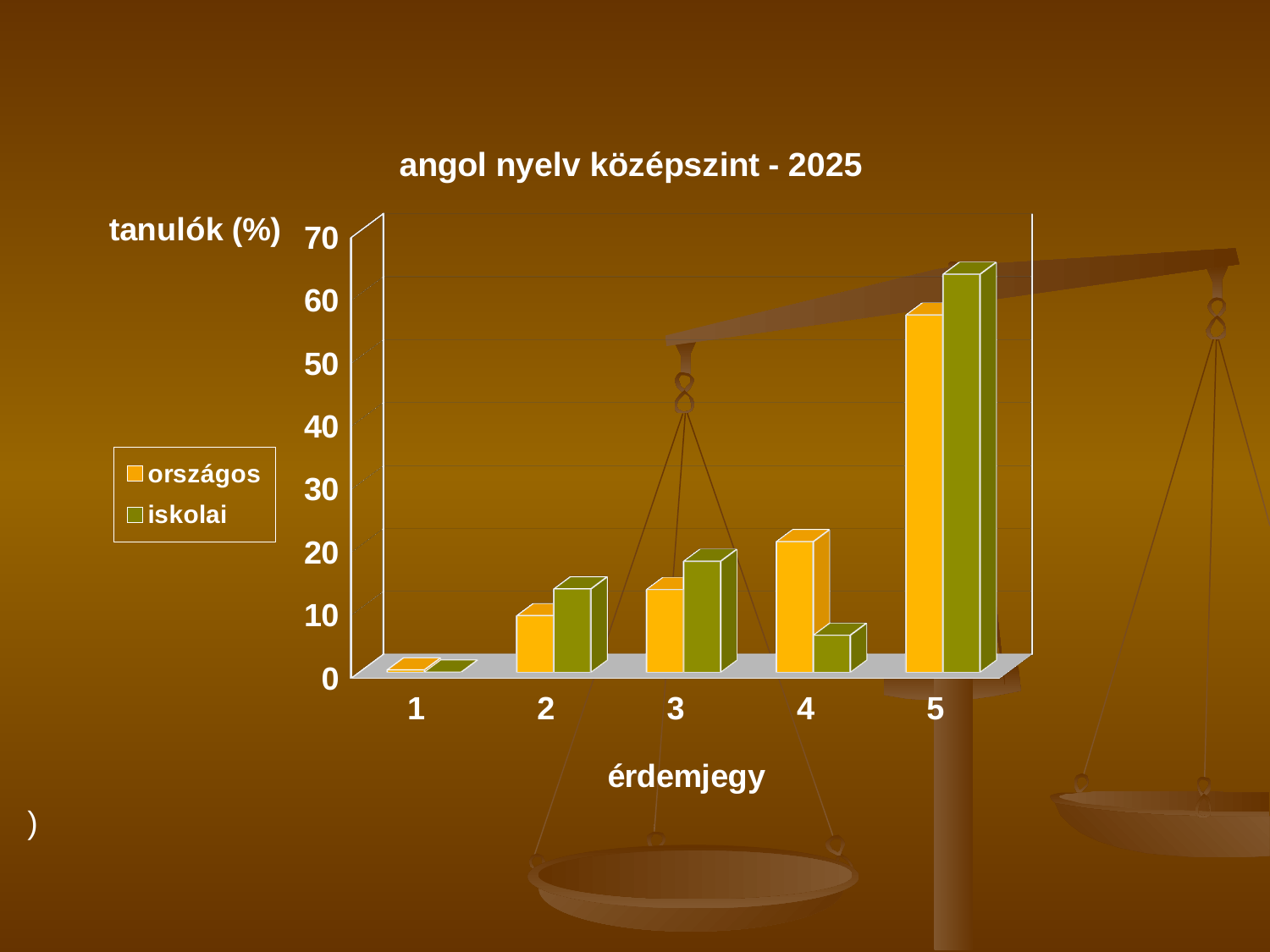
Is the iskolai value for érdemjegy 4 greater or less than 10? less How many series does the legend list? 2 Which series is shown in green in the legend? iskolai For which érdemjegy is the országos value highest? 5 For érdemjegy 2, which is larger: országos or iskolai? iskolai Do the országos values generally rise or fall from érdemjegy 1 to 5? rise How many categories (érdemjegy values) are shown on the x axis? 5 For érdemjegy 4, which is larger: országos or iskolai? országos For which érdemjegy is the iskolai value lowest? 1 What kind of chart is shown on the slide? bar chart Is the országos value for érdemjegy 5 greater or less than 50? greater What is the title of the chart? angol nyelv középszint - 2025